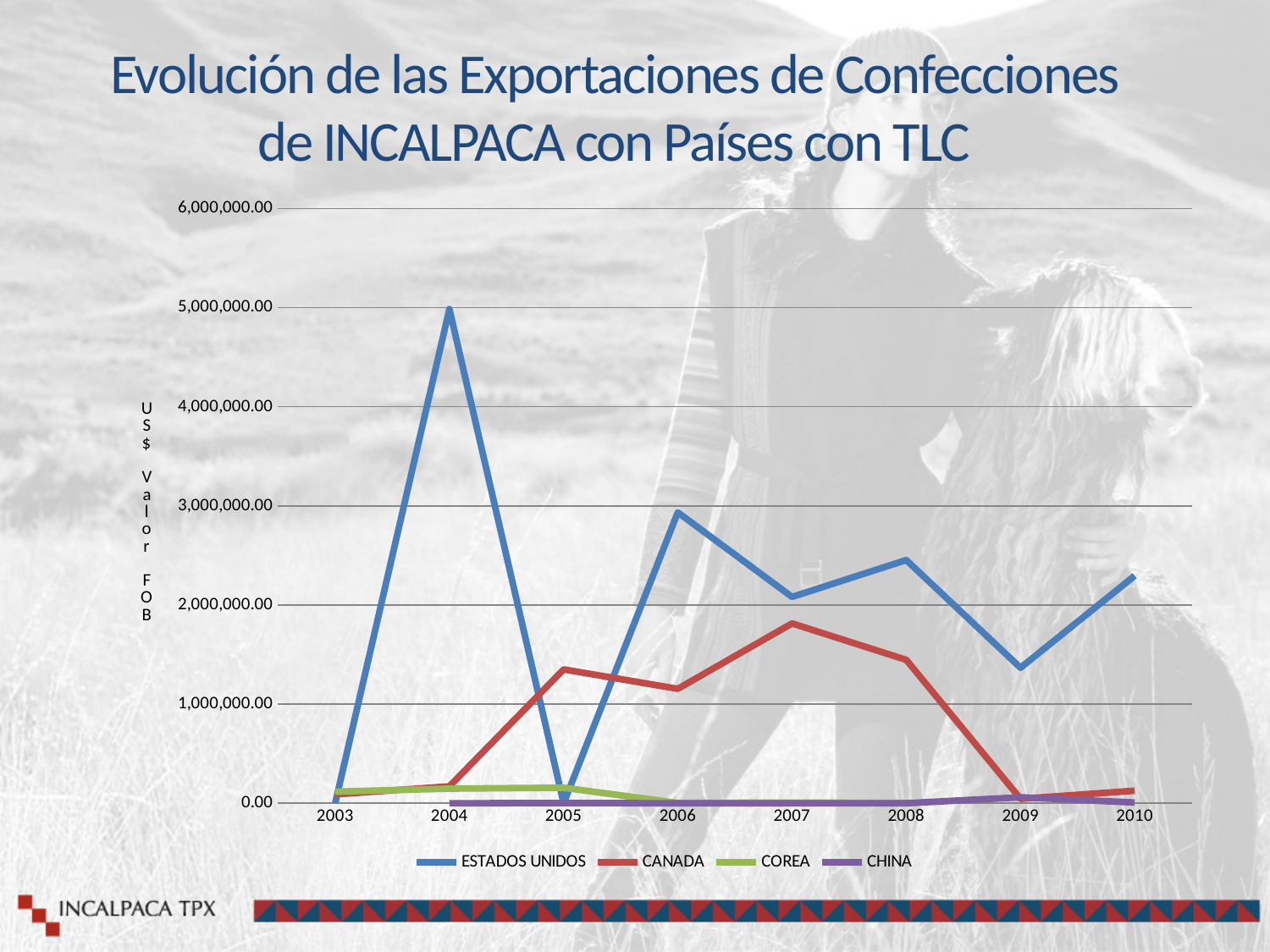
In which year did ESTADOS UNIDOS reach its highest value? 2004 Does the CANADA line rise or fall from 2008 to 2009? fall How many series does the legend list? 4 In which year did CANADA reach its highest value? 2007 Is the value for CANADA in 2009 greater or less than 1,000,000.00? less In 2007, which series has the larger value, ESTADOS UNIDOS or CANADA? ESTADOS UNIDOS Is the value for CANADA in 2007 greater or less than 1,000,000.00? greater In 2005, which series has the larger value, CANADA or ESTADOS UNIDOS? CANADA Is the value for ESTADOS UNIDOS in 2009 greater or less than 2,000,000.00? less What type of chart is shown on the slide? line chart How many years are plotted along the x axis? 8